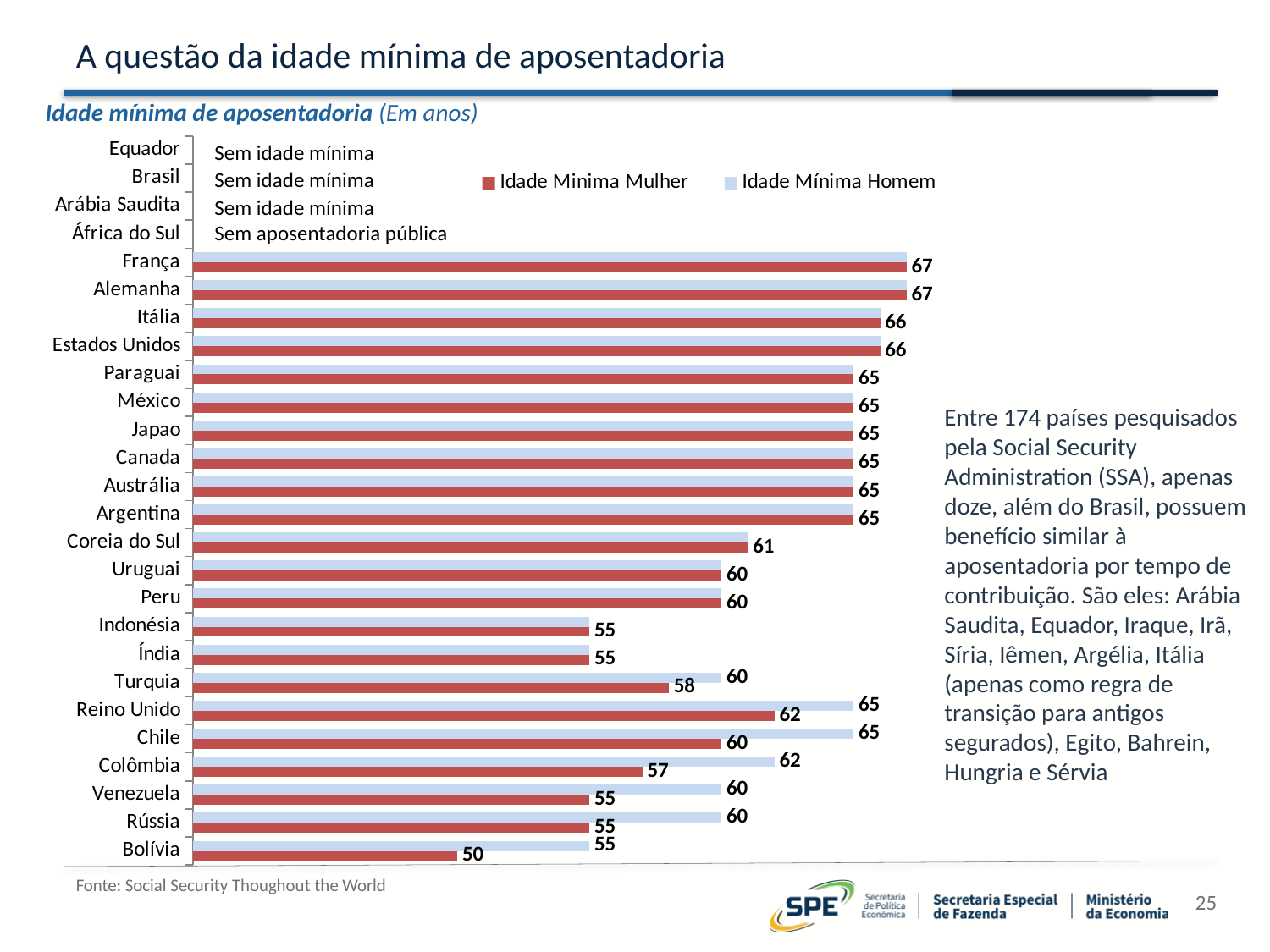
How many series does the legend list? 2 What is the difference between the Idade Mínima Homem and Idade Minima Mulher values for Chile? 5 Which country has the lowest Idade Minima Mulher value in the chart? Bolívia What is the Idade Mínima Homem value for Turquia? 60 What is the difference between the Idade Mínima Homem and Idade Minima Mulher values for Turquia? 2 What is the Idade Mínima Homem value for Colômbia? 62 What text is shown for África do Sul instead of a bar? Sem aposentadoria pública What is the highest minimum retirement age shown in the chart? 67 What kind of chart is shown on the slide? Bar chart What is the Idade Minima Mulher value for Bolívia? 50 Which is larger: the Idade Minima Mulher value for Reino Unido or for Chile? Reino Unido What is the Idade Minima Mulher value for Reino Unido? 62